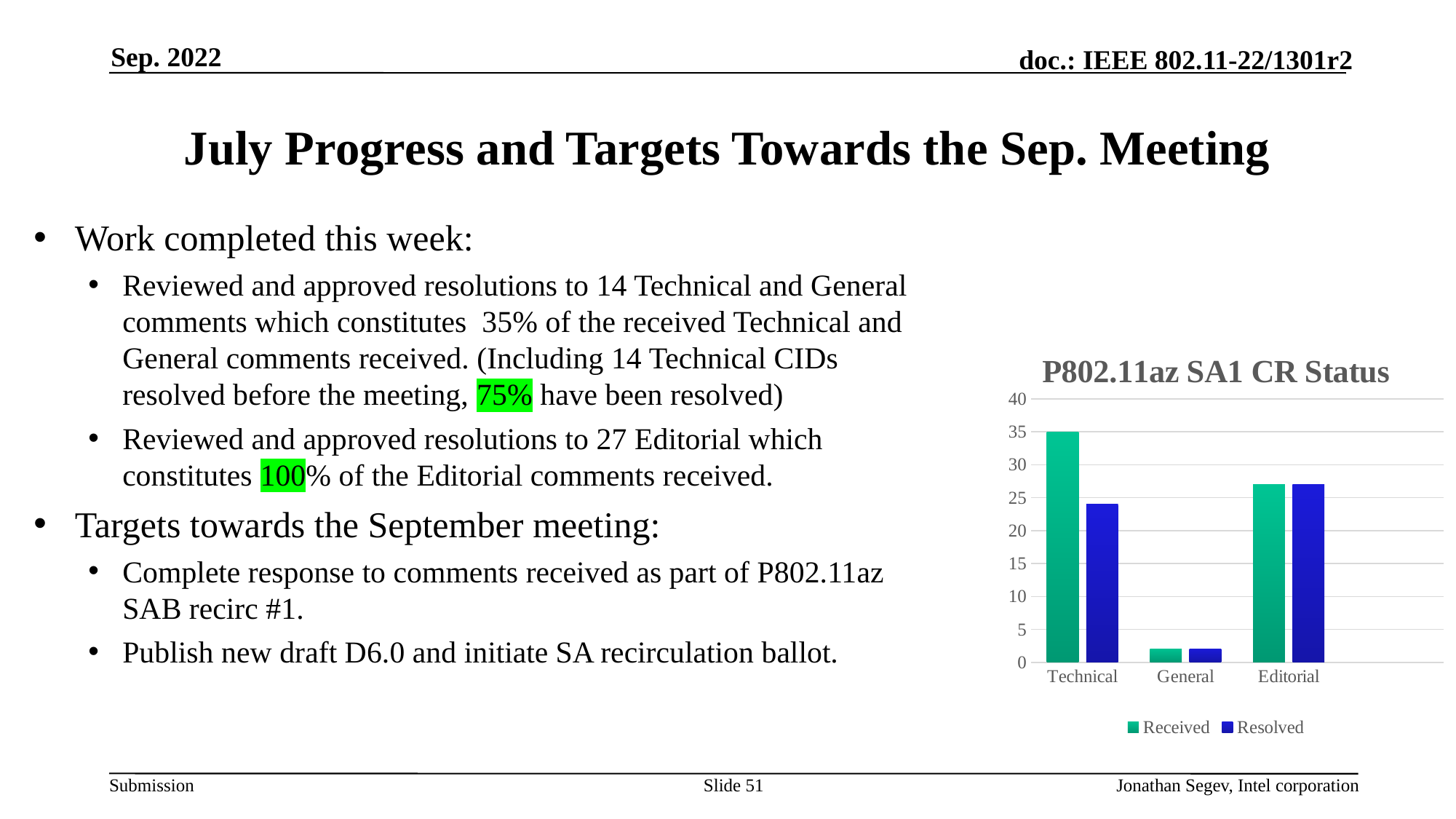
Is the Received value for Technical greater or less than 30? greater How many categories are shown on the x axis of the chart? 3 How many series does the chart legend list? 2 Is the Received value for General greater or less than 5? less What kind of chart is shown on the slide? bar chart Which category has the highest Resolved value? Editorial What is the title of the chart? P802.11az SA1 CR Status Which series is shown in blue in the chart legend? Resolved For Technical, which is larger: Received or Resolved? Received Which category has the lowest Received value? General Which category has the highest Received value? Technical